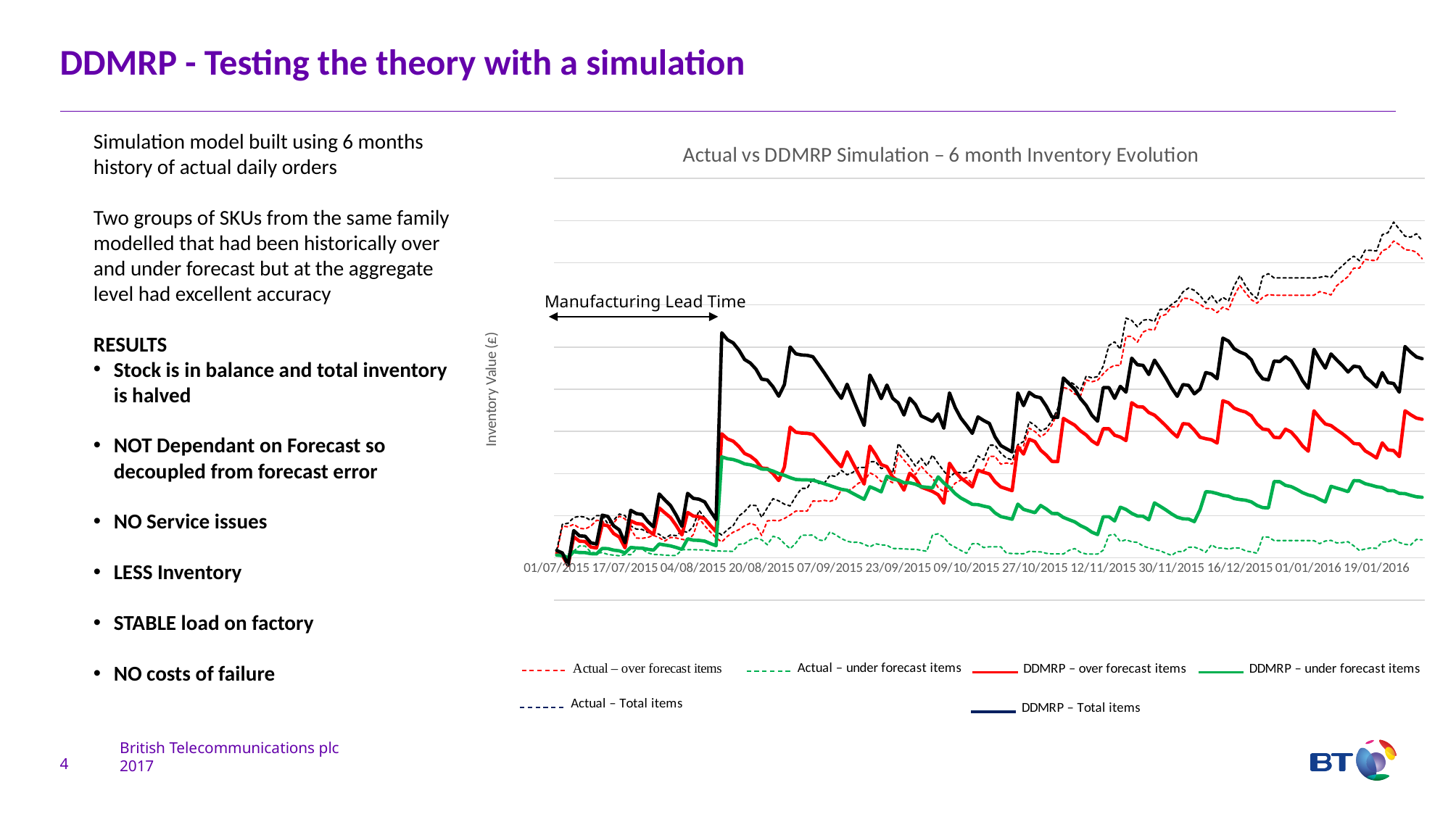
What is the first date label on the x axis of the chart? 01/07/2015 Which series is the highest at the right-hand end of the chart? Actual – Total items What is the title of the chart? Actual vs DDMRP Simulation – 6 month Inventory Evolution Does the Actual – over forecast items series rise or fall from 01/07/2015 to 19/01/2016? Rise What is the label on the vertical axis of the chart? Inventory Value (£) What kind of chart is shown on the slide? Line chart Near the end of the chart, which is higher: DDMRP – over forecast items or DDMRP – under forecast items? DDMRP – over forecast items How many series does the chart legend list? 6 Which series is the lowest at the right-hand end of the chart? Actual – under forecast items At the end of the period (19/01/2016), which is higher: Actual – Total items or DDMRP – Total items? Actual – Total items How many date labels are shown along the x axis of the chart? 13 Does the Actual – Total items series rise or fall over the period shown? Rise